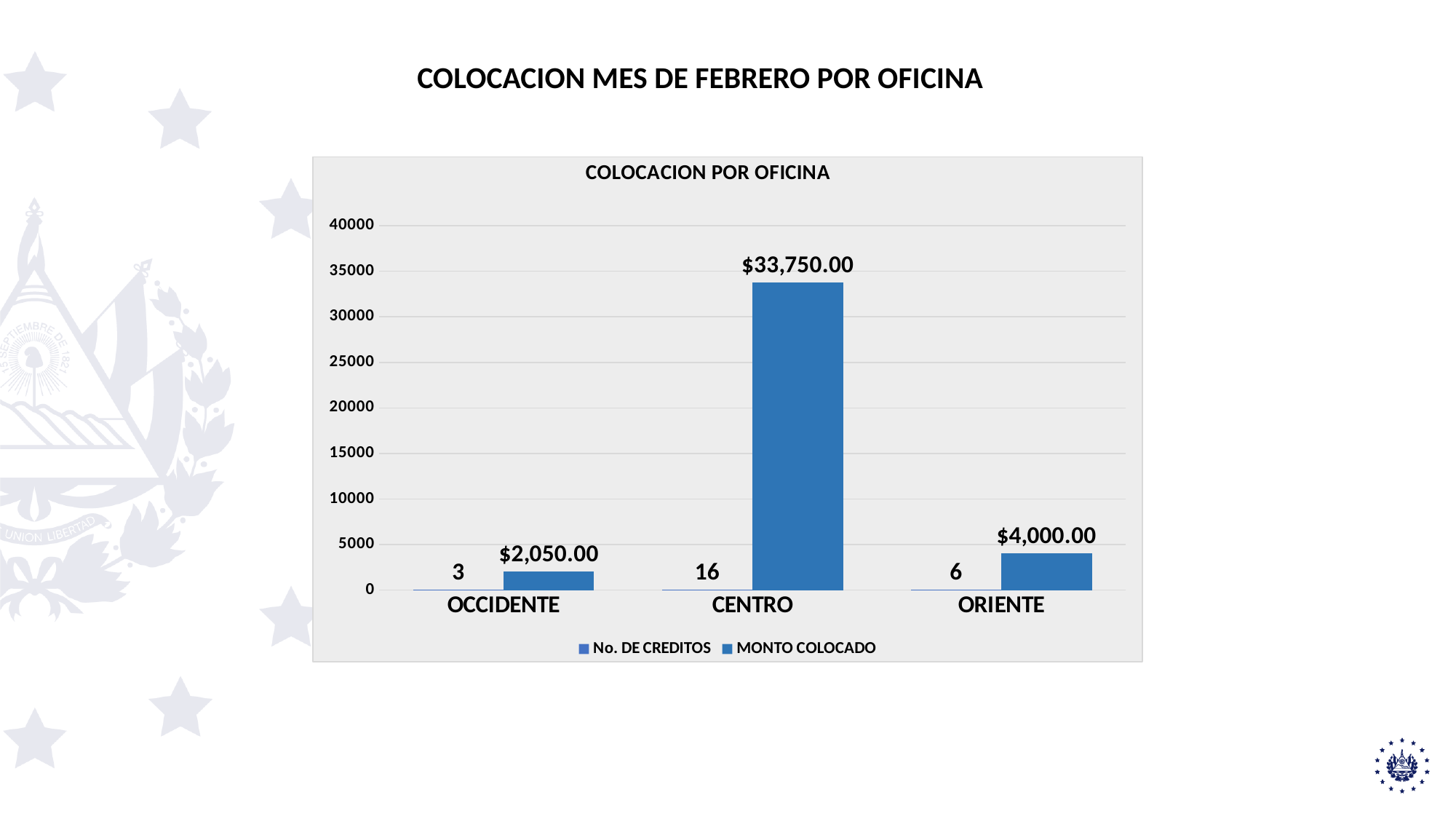
What is the MONTO COLOCADO value for CENTRO? $33,750.00 What type of chart is shown on the slide? Bar chart Which office has the highest MONTO COLOCADO? CENTRO What is the No. DE CREDITOS value for CENTRO? 16 What is the difference in MONTO COLOCADO between CENTRO and ORIENTE? $29,750.00 Is the MONTO COLOCADO for CENTRO greater or less than 30000? greater Which office has the lowest No. DE CREDITOS? OCCIDENTE How many series does the chart legend list? 2 What is the No. DE CREDITOS value for ORIENTE? 6 Which office has a larger MONTO COLOCADO, OCCIDENTE or ORIENTE? ORIENTE How many offices are shown on the x axis of the chart? 3 What is the MONTO COLOCADO value for OCCIDENTE? $2,050.00